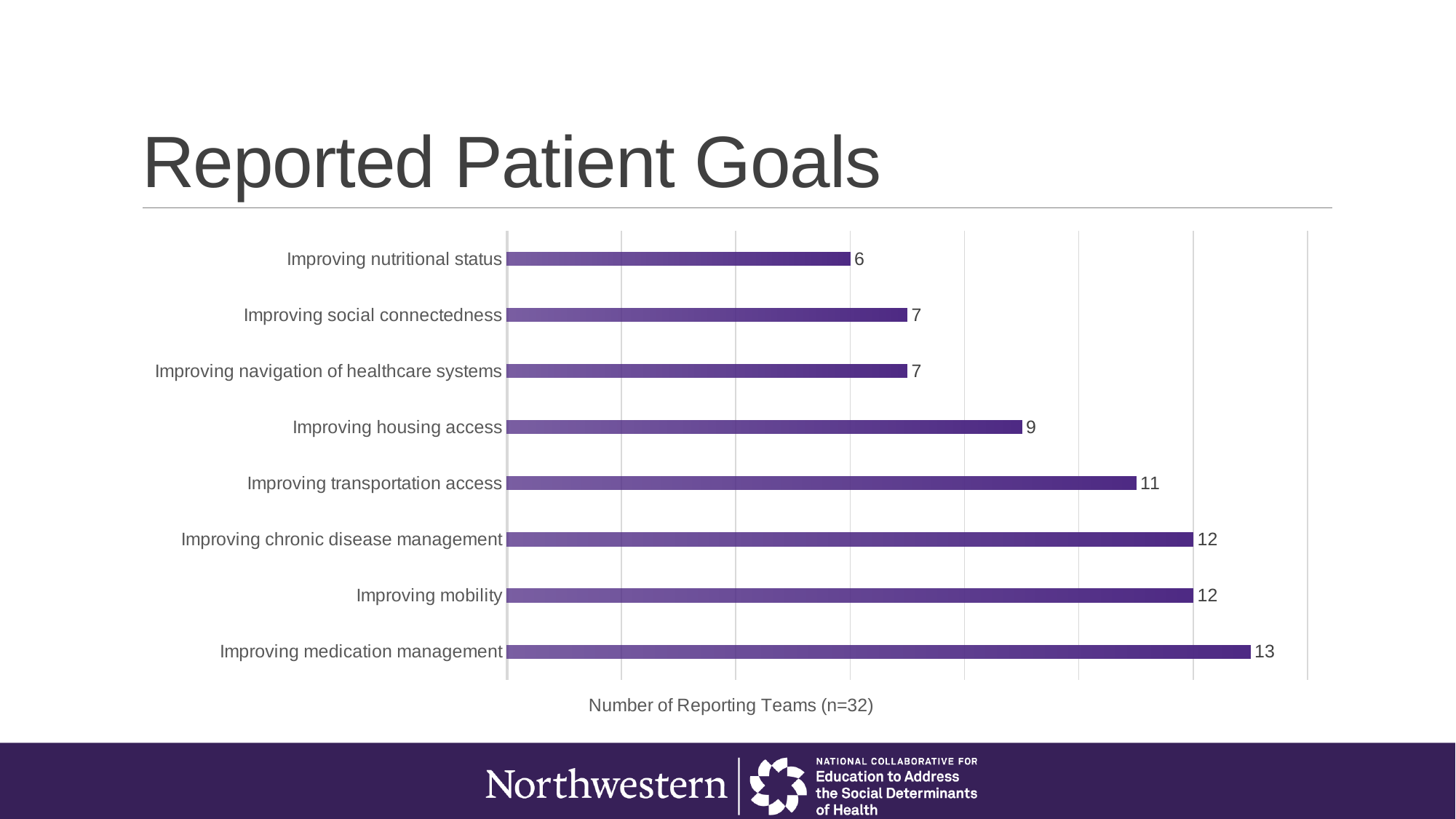
What is the value for improving transportation access? 11 What is the label on the horizontal axis of the chart? Number of Reporting Teams (n=32) Which patient goal was reported by the most teams? Improving medication management Which patient goal was reported by the fewest teams? Improving nutritional status What is the difference between the values for improving medication management and improving nutritional status? 7 How many reporting teams listed improving medication management as a patient goal? 13 What is the value for improving nutritional status? 6 How many patient goal categories are shown in the chart? 8 What kind of chart is shown on the slide? Bar chart Which has a larger value, improving housing access or improving social connectedness? Improving housing access What is the difference between the values for improving transportation access and improving housing access? 2 What is the value for improving housing access? 9